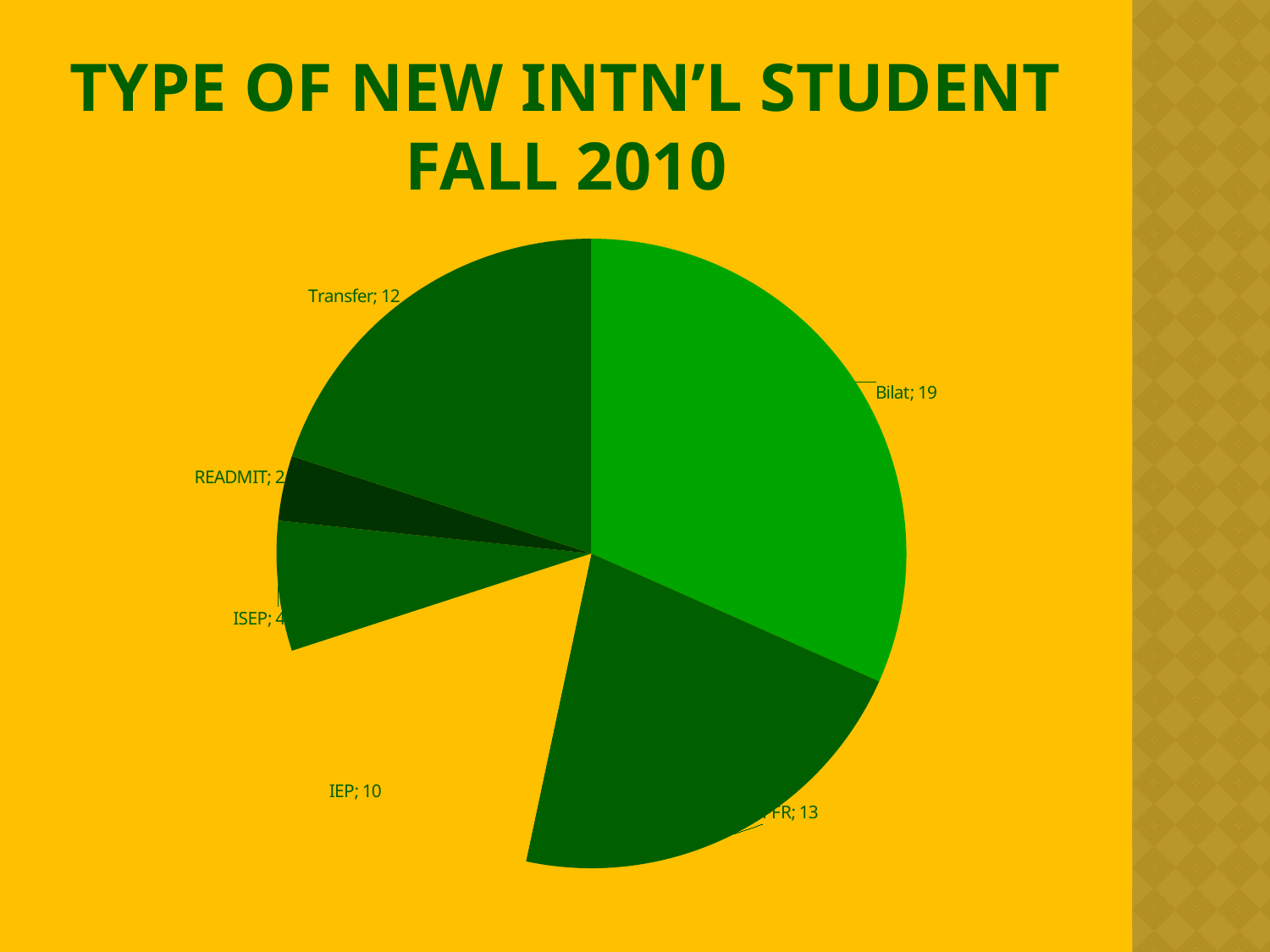
What type of chart is shown on the slide? pie chart Which type of new international student has the largest slice? Bilat How many new international students in Fall 2010 were Bilat? 19 What share of the total does the Transfer slice represent? 20% What is the title of the chart? TYPE OF NEW INTN'L STUDENT FALL 2010 What is the difference between the Bilat and FR values? 6 Which is larger, the value for Transfer or the value for IEP? Transfer What is the value shown for Transfer? 12 How many categories are shown in the pie chart? 6 What is the value shown for IEP? 10 What is the value shown for FR? 13 Which type of new international student has the smallest slice? READMIT